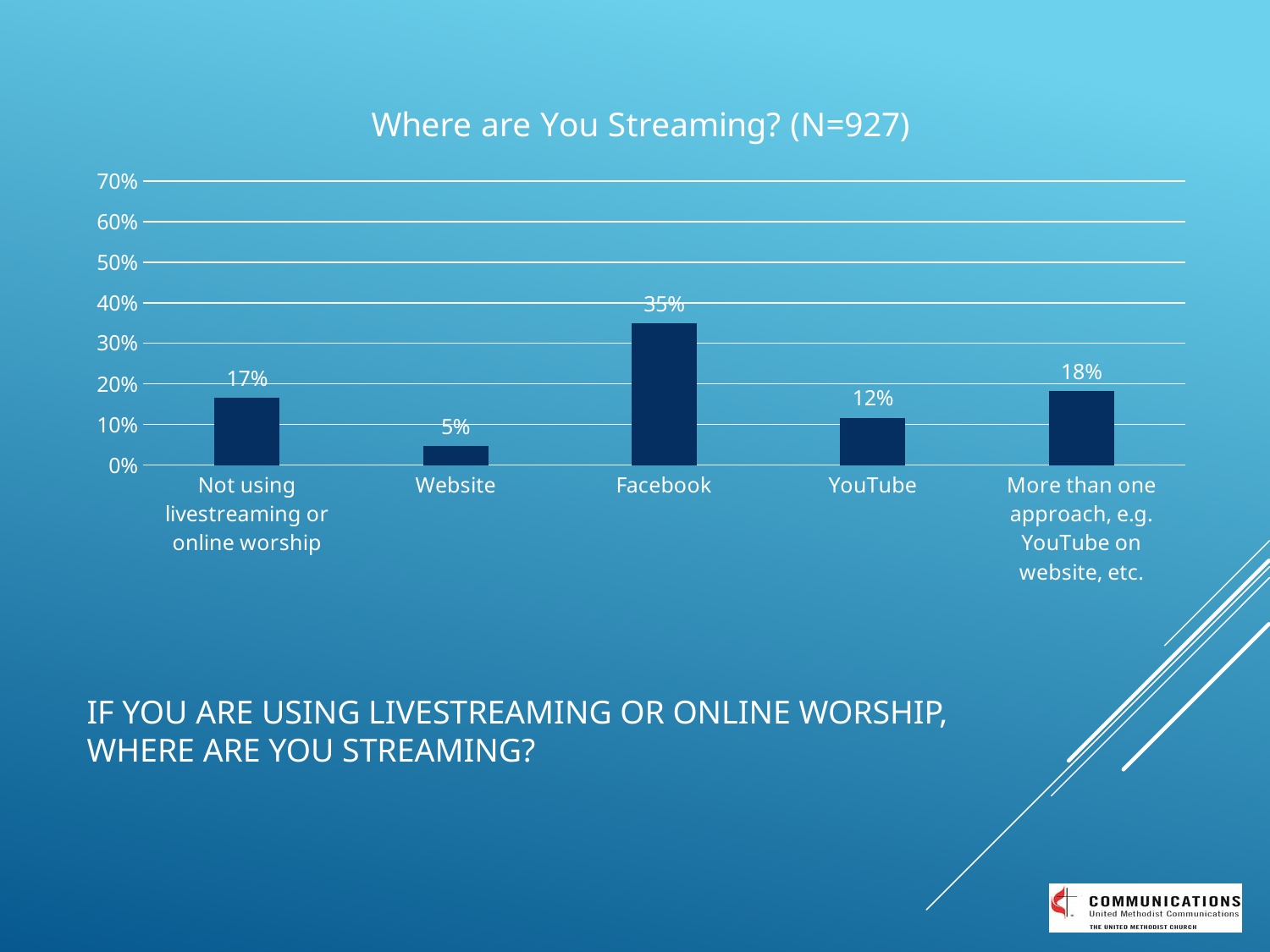
What percentage of respondents are streaming on Facebook? 35% What percentage of respondents are streaming on YouTube? 12% Which is larger, the value for Website or the value for YouTube? YouTube How many categories are shown on the x axis? 5 What percentage of respondents are not using livestreaming or online worship? 17% Which category has the highest value? Facebook Which category has the lowest value? Website What percentage of respondents use more than one approach, e.g. YouTube on website, etc.? 18% What is the title of the chart? Where are You Streaming? (N=927) What is the difference between the Facebook value and the YouTube value? 23% What kind of chart is shown on the slide? bar chart Is the value for Facebook greater or less than 30%? greater